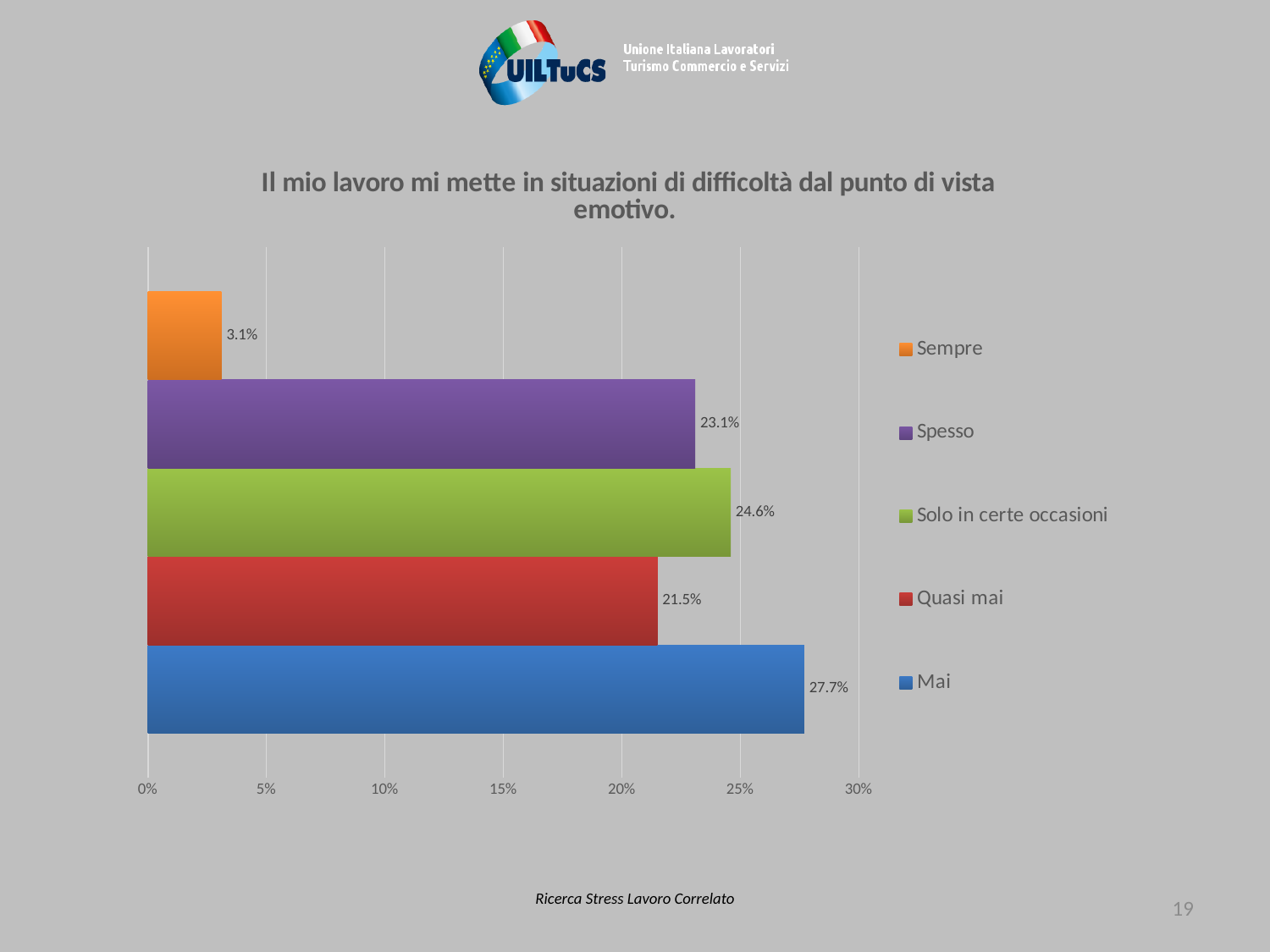
Is the value for Solo in certe occasioni greater or less than 20%? greater What is the value for Quasi mai? 21.5% What is the value for Sempre? 3.1% Which category has the highest value? Mai How many categories are shown in the chart? 5 What is the value for Mai? 27.7% What is the value for Solo in certe occasioni? 24.6% Which category has the lowest value? Sempre What colour is the bar for Spesso? Purple What is the difference between the values for Mai and Spesso? 4.6% Which is larger, the value for Spesso or the value for Quasi mai? Spesso What kind of chart is shown on the slide? Bar chart